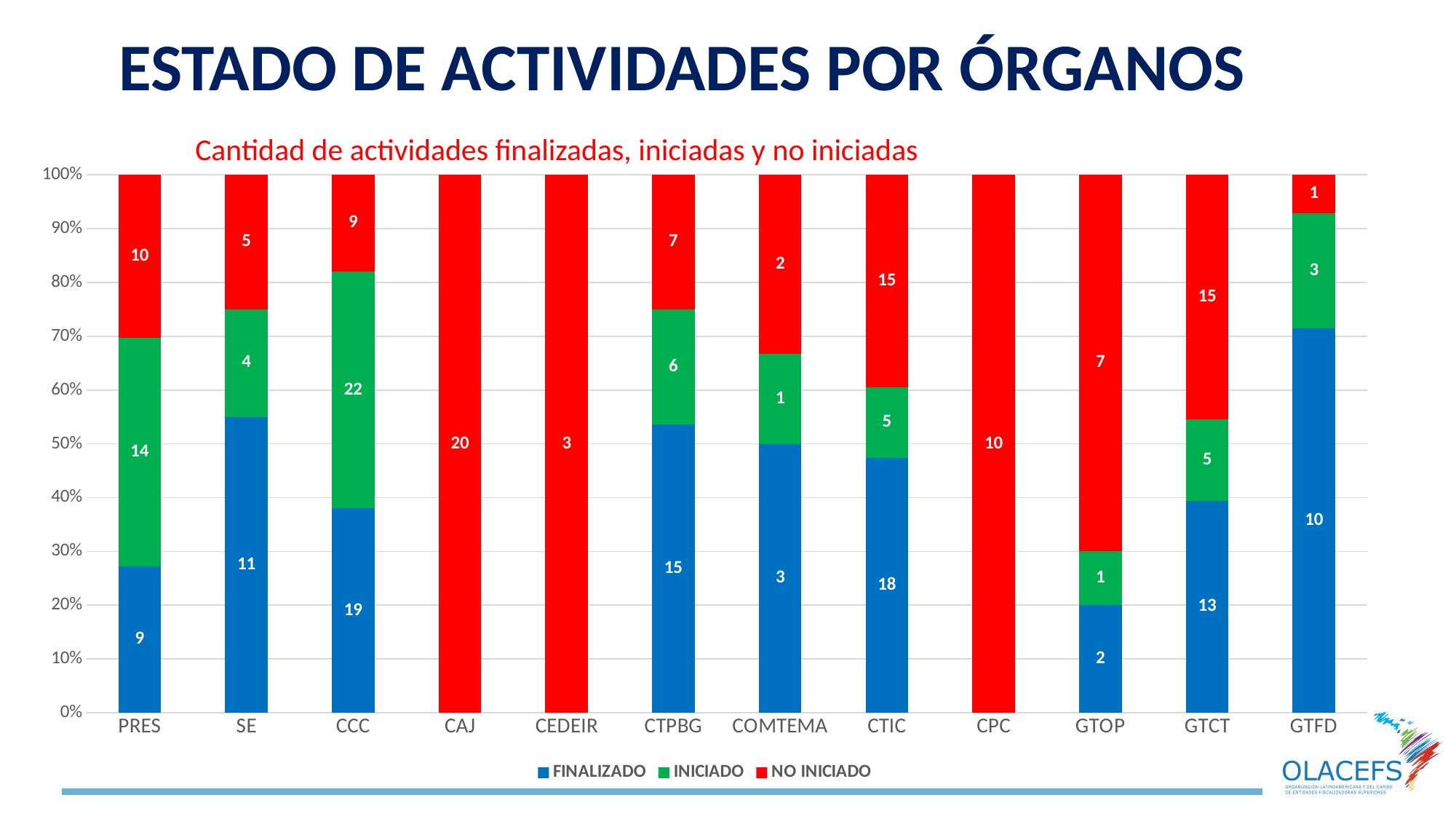
Is the FINALIZADO share of the SE bar greater or less than 50%? greater How many series does the legend list? 3 What is the INICIADO value for PRES? 14 Which is larger, the NO INICIADO value for GTOP or for CTPBG? Neither; they are equal (both 7) What is the FINALIZADO value for CCC? 19 What is the NO INICIADO value for CAJ? 20 How many organs (categories) are shown on the x axis? 12 Which organ has the lowest NO INICIADO value? GTFD Which organ has the highest INICIADO value? CCC What is the total number of activities for CTIC (sum of the three segments)? 38 What kind of chart is shown on the slide? Stacked bar chart What is the difference between the FINALIZADO values of CTIC and GTCT? 5